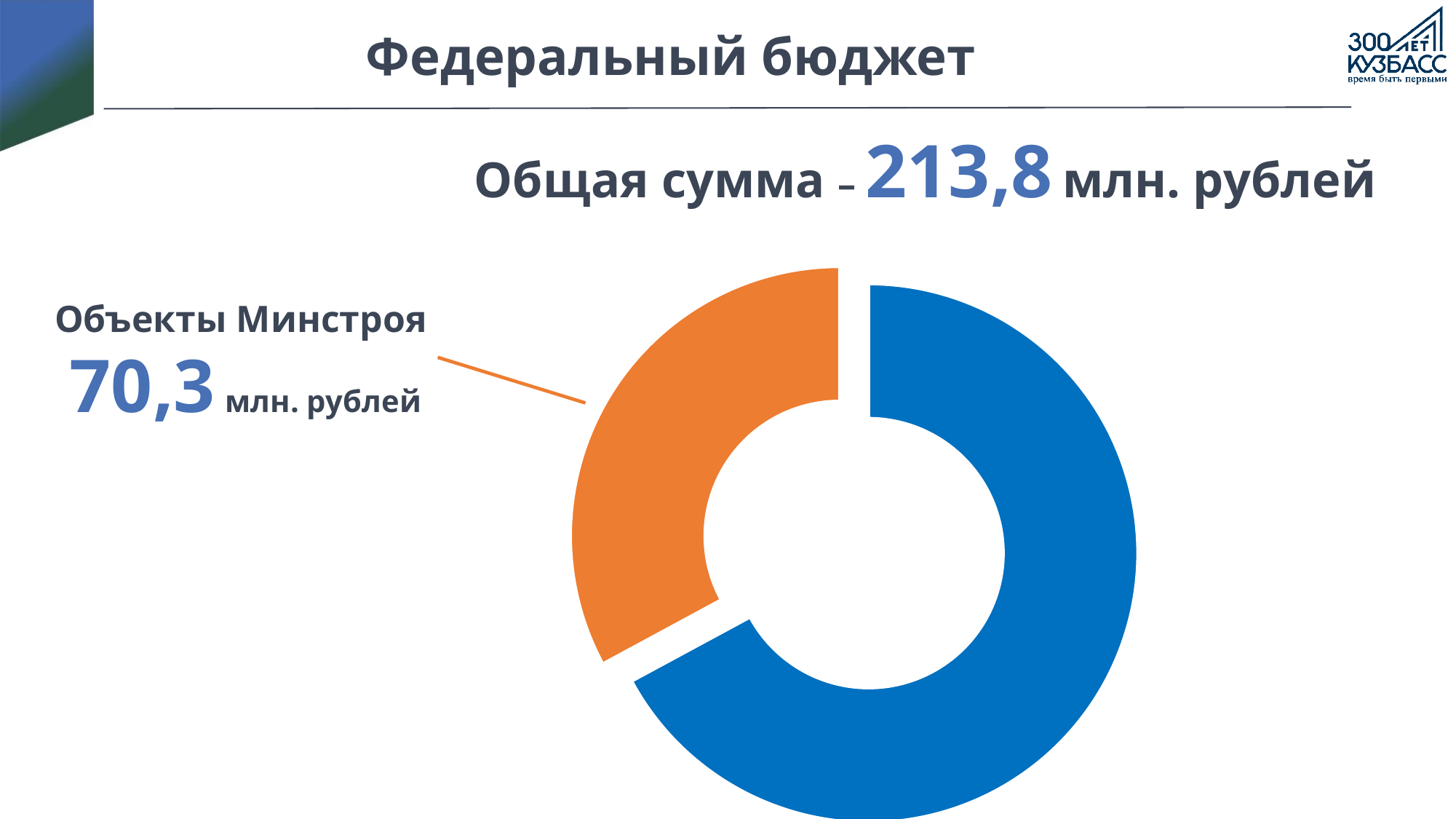
What is the total amount (Общая сумма) shown on the slide? 213,8 млн. рублей What colour is the slice for Объекты Минстроя? orange What is the title of the slide? Федеральный бюджет What share of the total amount does Объекты Минстроя represent? 32,9% Which slice is larger, the orange one or the blue one? the blue one What is the difference between the total amount and the value for Объекты Минстроя? 143,5 млн. рублей What is the value for Объекты Минстроя? 70,3 млн. рублей Which slice of the chart is the smallest? Объекты Минстроя (orange) Which slice of the chart is the largest? the blue slice What kind of chart is shown on the slide? pie chart (donut) How many slices does the chart have? 2